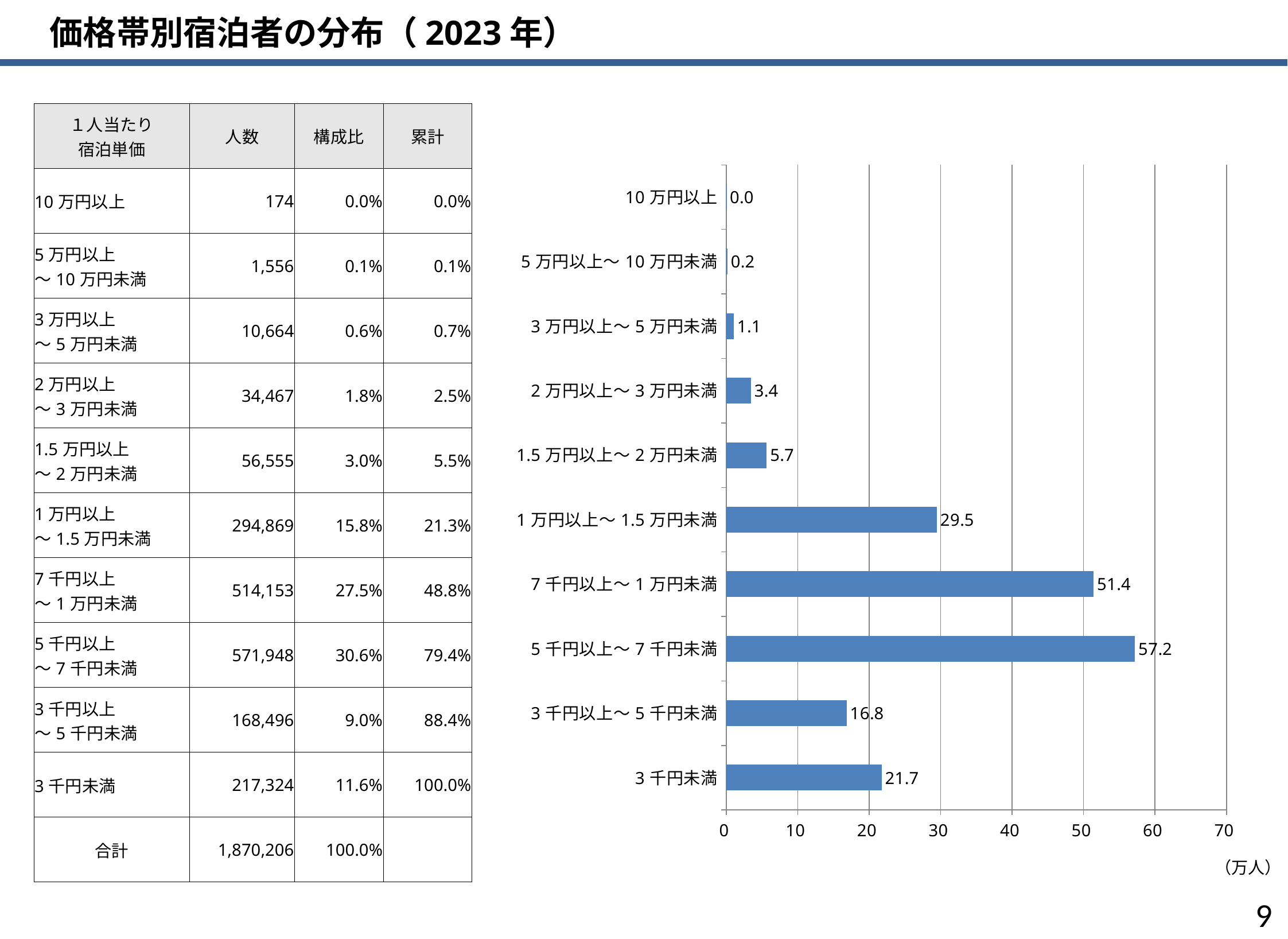
What is the unit shown below the x axis of the bar chart? 万人 Which category has the highest value in the bar chart? 5千円以上～7千円未満 How many categories are shown in the bar chart? 10 What is the maximum value shown on the x axis of the bar chart? 70 What is the value for 5千円以上～7千円未満 in the bar chart? 57.2 Which is larger in the bar chart: 3千円未満 or 3千円以上～5千円未満? 3千円未満 Is the value for 7千円以上～1万円未満 in the bar chart greater or less than 50? greater What kind of chart is shown on the slide? Bar chart What is the difference between the values for 5千円以上～7千円未満 and 7千円以上～1万円未満 in the bar chart? 5.8 Which category has the lowest value in the bar chart? 10万円以上 What is the value for 1万円以上～1.5万円未満 in the bar chart? 29.5 What is the value for 3千円未満 in the bar chart? 21.7